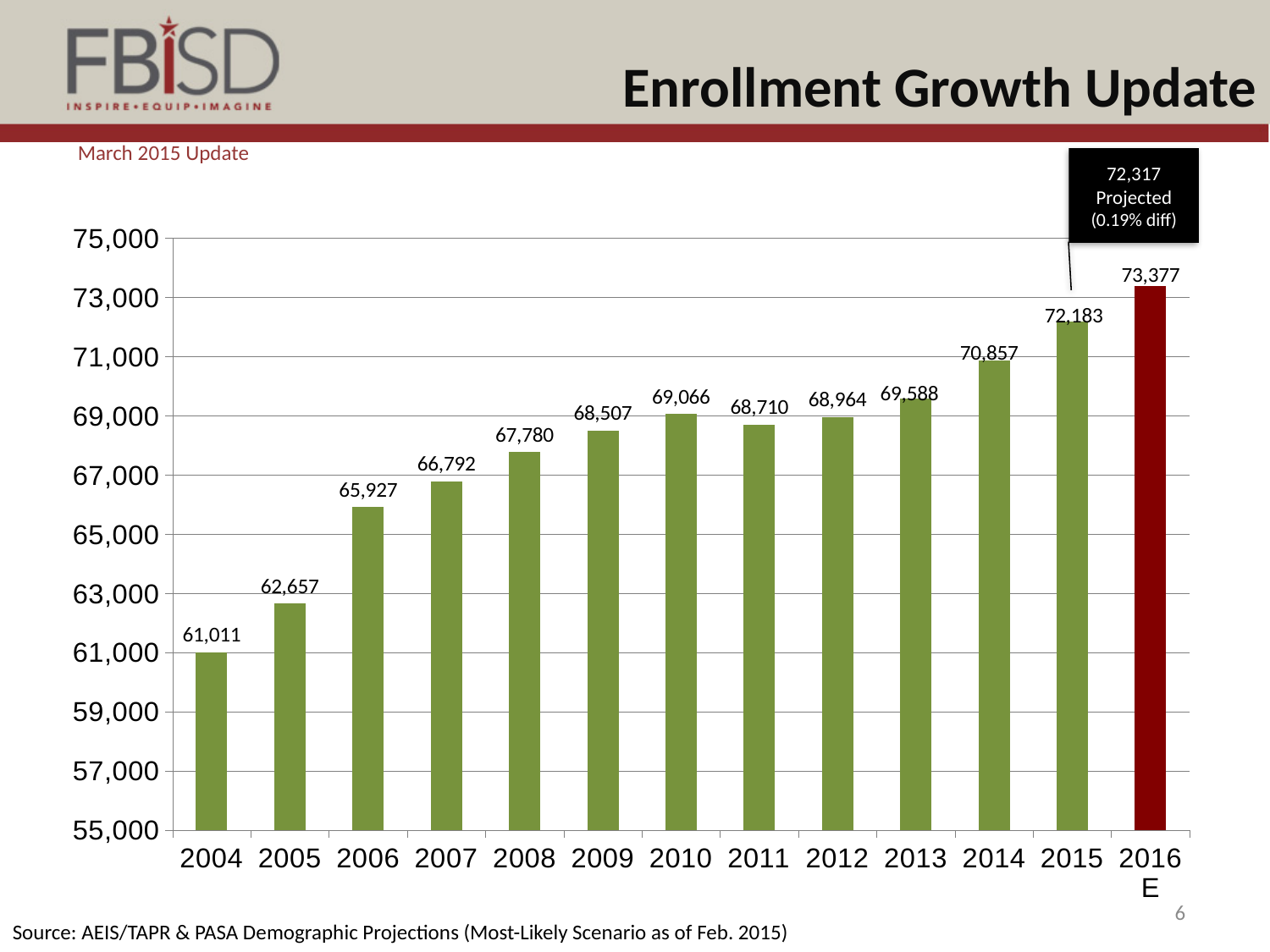
What is the enrollment value shown for 2011? 68,710 What is the enrollment value shown for 2016E? 73,377 How many years (bars) are shown on the chart? 13 Which is larger, the enrollment value for 2010 or for 2011? 2010 Which year has the lowest enrollment value on the chart? 2004 What is the difference between the enrollment values for 2015 and 2014? 1,326 What kind of chart is shown on the slide? Bar chart What is the enrollment value shown for 2004? 61,011 Which year has the highest enrollment value on the chart? 2016E Is the enrollment value for 2006 greater or less than 65,000? greater Do the enrollment values generally rise or fall from 2004 to 2016E? Rise What projected value does the callout box above the 2015 bar show? 72,317